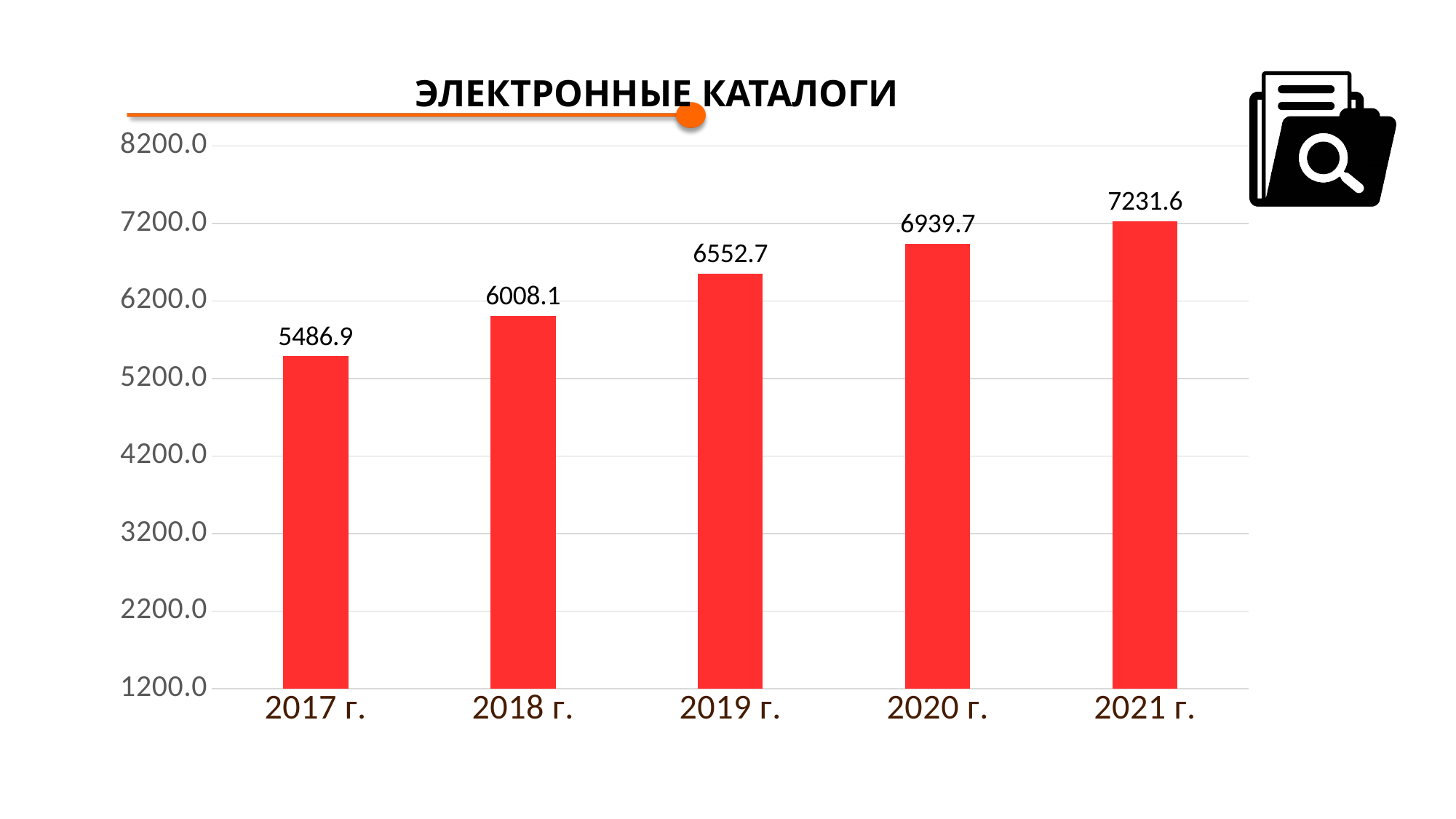
How many years are shown on the chart? 5 What is the difference between the values for 2021 г. and 2017 г.? 1744.7 What kind of chart is shown on the slide? bar chart Which year has the lowest value? 2017 г. Do the values rise or fall from 2017 г. to 2021 г.? rise What is the value for 2019 г.? 6552.7 Which is larger, the value for 2018 г. or the value for 2020 г.? 2020 г. Which year has the highest value? 2021 г. What is the difference between the values for 2020 г. and 2019 г.? 387.0 What is the value for 2021 г.? 7231.6 What is the value for 2017 г.? 5486.9 Is the value for 2018 г. greater or less than 6200.0? less